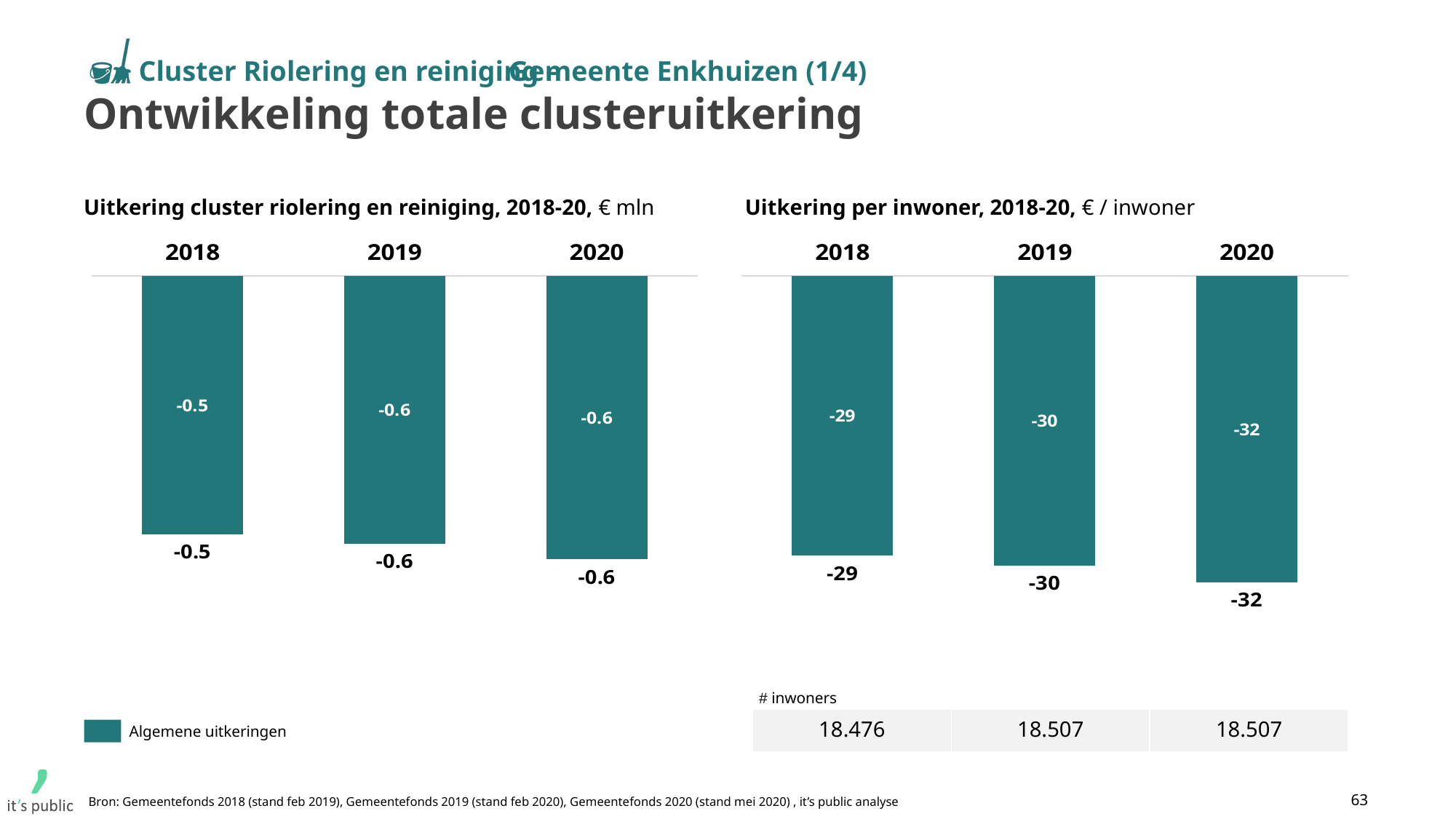
What is the legend entry shown below the left chart? Algemene uitkeringen In the chart 'Uitkering per inwoner, 2018-20', which year has the highest value? 2018 In the chart 'Uitkering cluster riolering en reiniging, 2018-20', which is larger, the value for 2018 or the value for 2019? 2018 In the chart 'Uitkering cluster riolering en reiniging, 2018-20', what is the value for 2020? -0.6 In the chart 'Uitkering cluster riolering en reiniging, 2018-20', what is the value for 2018? -0.5 How many years are shown in the chart 'Uitkering per inwoner, 2018-20'? 3 In the chart 'Uitkering per inwoner, 2018-20', which year has the lowest value? 2020 In the chart 'Uitkering per inwoner, 2018-20', do the values rise or fall from 2018 to 2020? Fall What kind of chart is 'Uitkering cluster riolering en reiniging, 2018-20'? Bar chart In the chart 'Uitkering per inwoner, 2018-20', what is the value for 2019? -30 In the chart 'Uitkering per inwoner, 2018-20', what is the value for 2020? -32 In the chart 'Uitkering per inwoner, 2018-20', what is the difference between the values for 2018 and 2020? 3